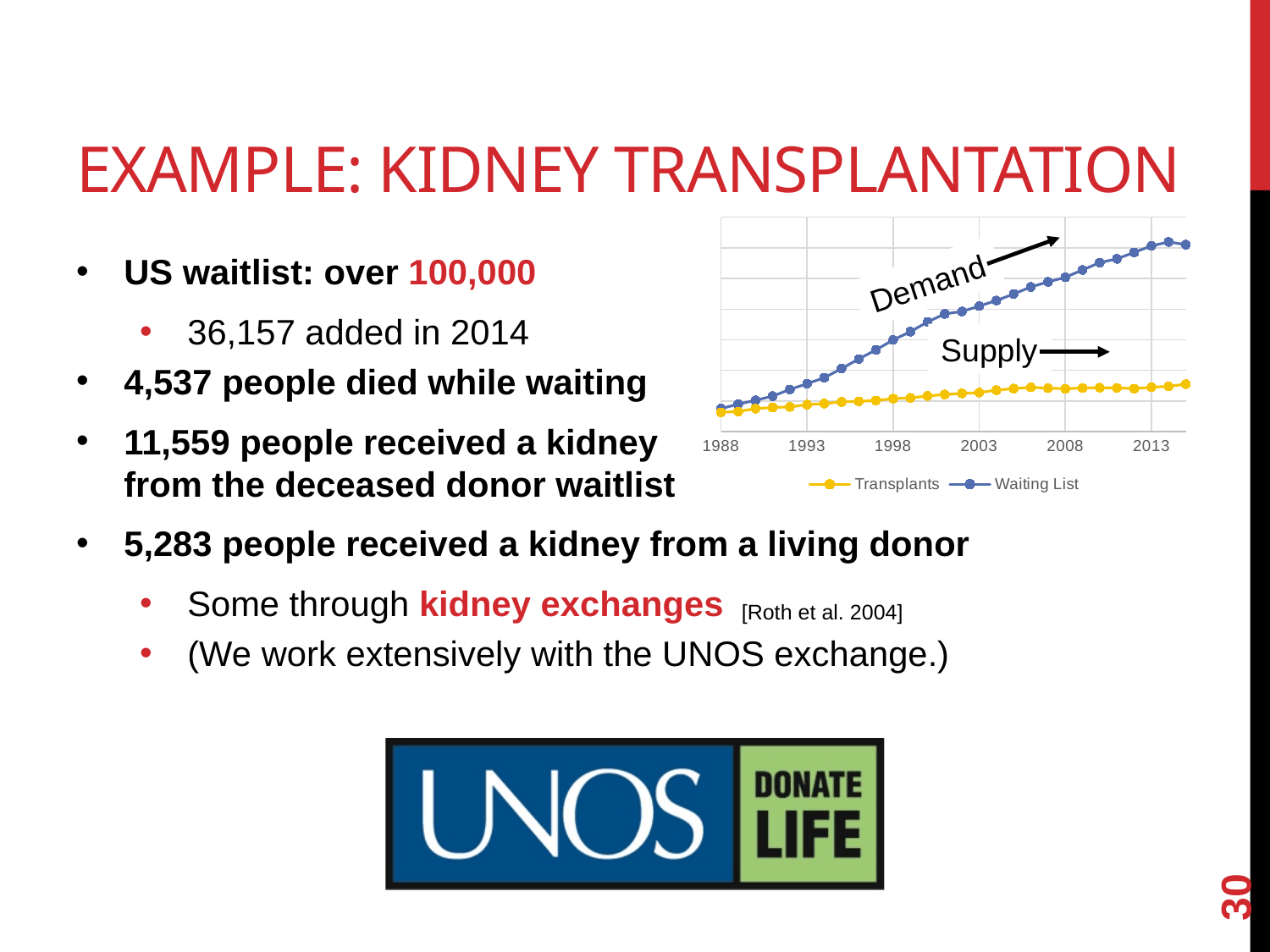
Which series rises more steeply over the period shown, Transplants or Waiting List? Waiting List How many series does the chart's legend list? 2 Does the Waiting List series rise or fall from 1988 to 2013? rise What are the two series named in the chart's legend? Transplants and Waiting List What is the last year labelled on the chart's x axis? 2013 Which series is higher in 2013, Transplants or Waiting List? Waiting List What is the first year labelled on the chart's x axis? 1988 Which series is drawn in blue in the chart? Waiting List Does the Transplants series rise or fall from 1988 to 2013? rise What kind of chart is shown on the slide? line chart Which series reaches the highest point on the chart? Waiting List Which series has the lowest values at the right end of the chart? Transplants